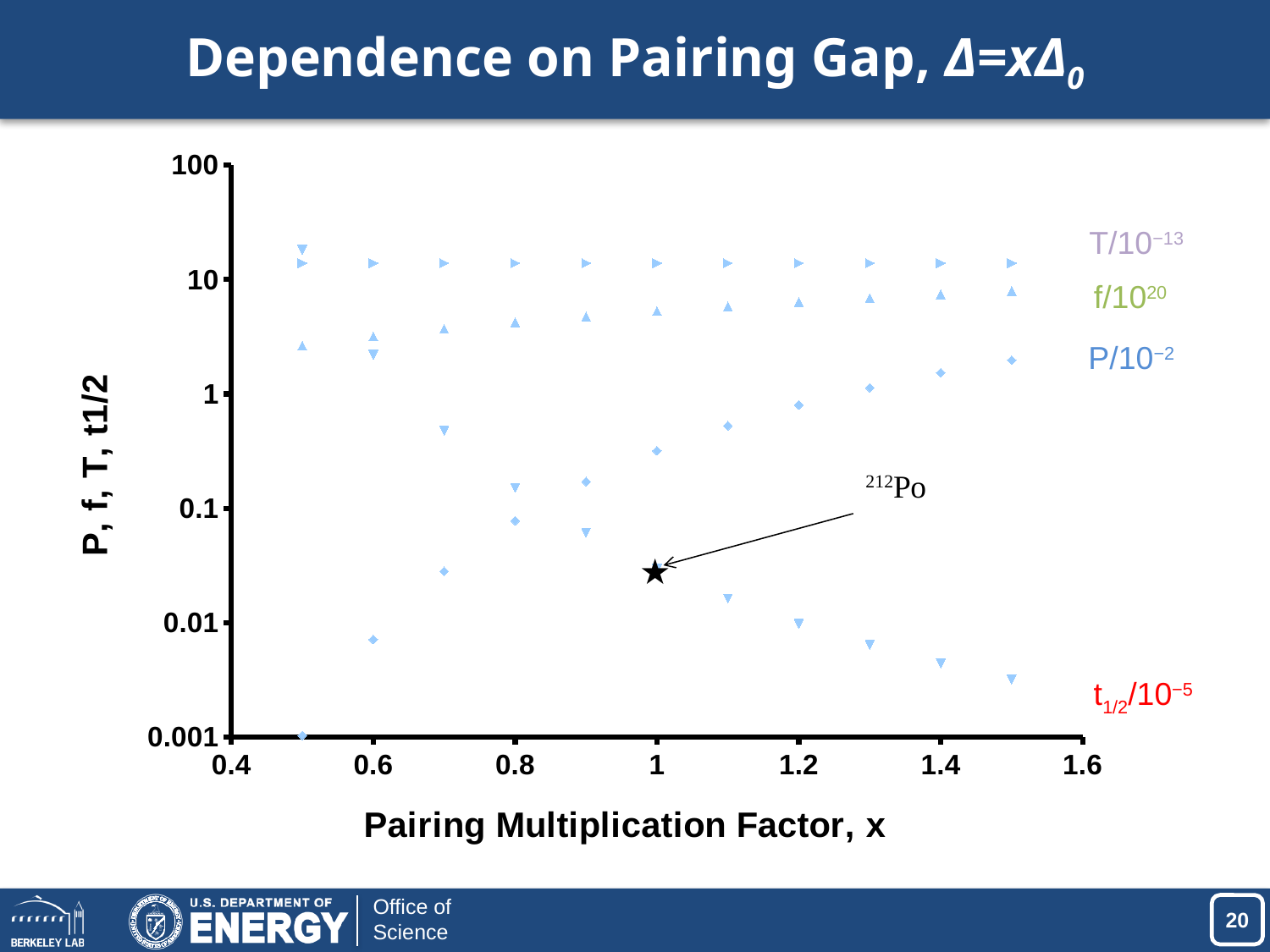
Do the values of the f/10^20 series rise or fall as x increases? rise What kind of chart is shown on the slide? scatter chart What does the black star on the chart mark? 212Po Which series has the lowest value at x = 1.5? t1/2/10^-5 Do the values of the t1/2/10^-5 series rise or fall as x increases? fall Do the values of the P/10^-2 series rise or fall as x increases? rise How many data series are plotted on the chart? 4 Is the value of the T/10^-13 series at x = 1.0 greater or less than 10? greater What is the title of the x axis? Pairing Multiplication Factor, x Is the value of the t1/2/10^-5 series at x = 1.5 greater or less than 0.01? less Is the value of the f/10^20 series at x = 0.5 greater or less than 1? greater